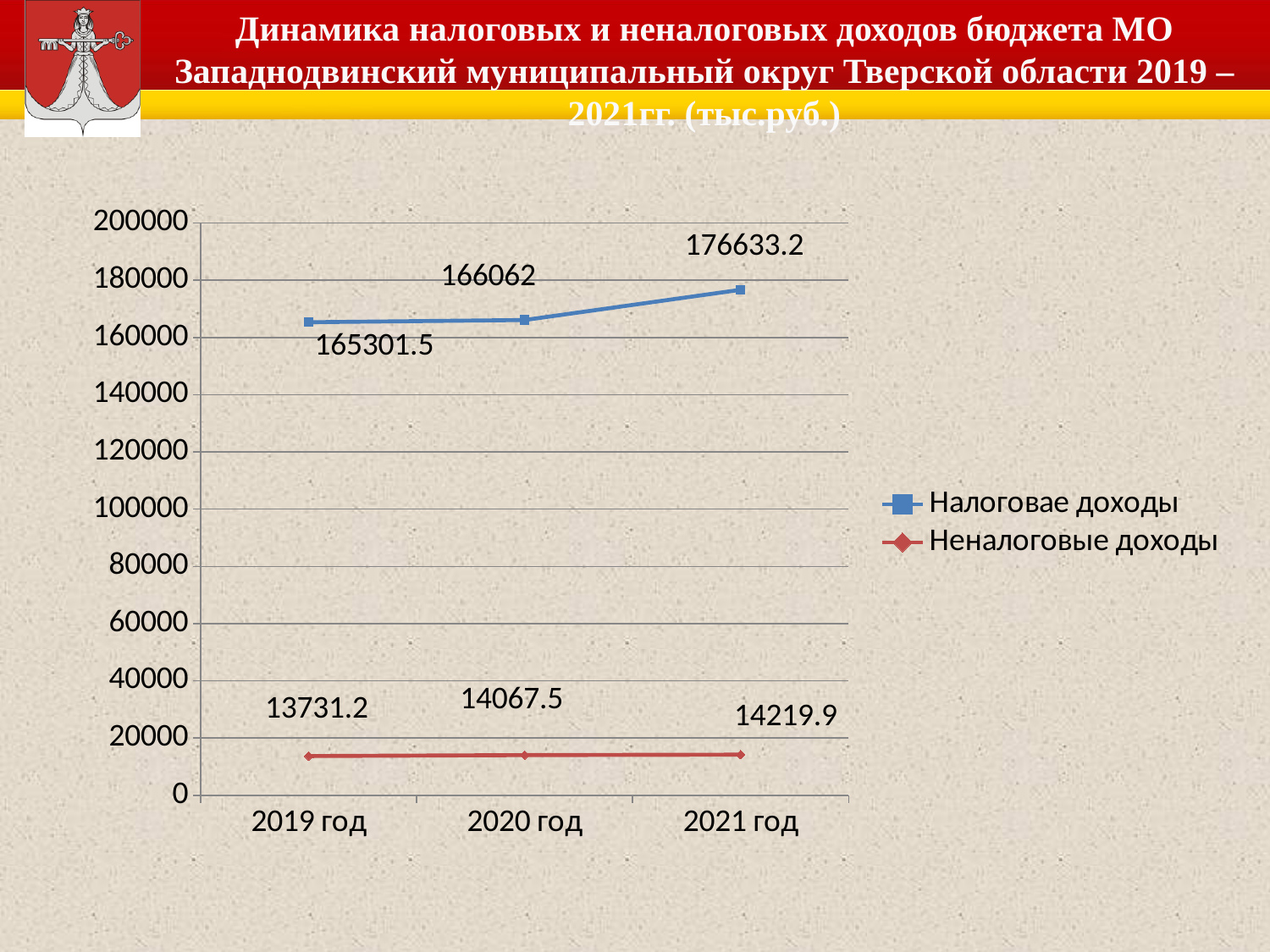
What is the value of Налоговае доходы for 2020 год? 166062 What kind of chart is shown on the slide? line chart What is the difference between Налоговае доходы in 2021 год and 2019 год? 11331.7 What is the value of Налоговае доходы for 2021 год? 176633.2 In which year is Налоговае доходы highest? 2021 год How many series does the legend list? 2 How many years are shown on the x axis? 3 Which is larger in 2020 год: Налоговае доходы or Неналоговые доходы? Налоговае доходы What is the value of Неналоговые доходы for 2019 год? 13731.2 What is the difference between Неналоговые доходы in 2021 год and 2019 год? 488.7 Is the value of Неналоговые доходы for 2021 год greater or less than 20000? less In which year is Неналоговые доходы lowest? 2019 год